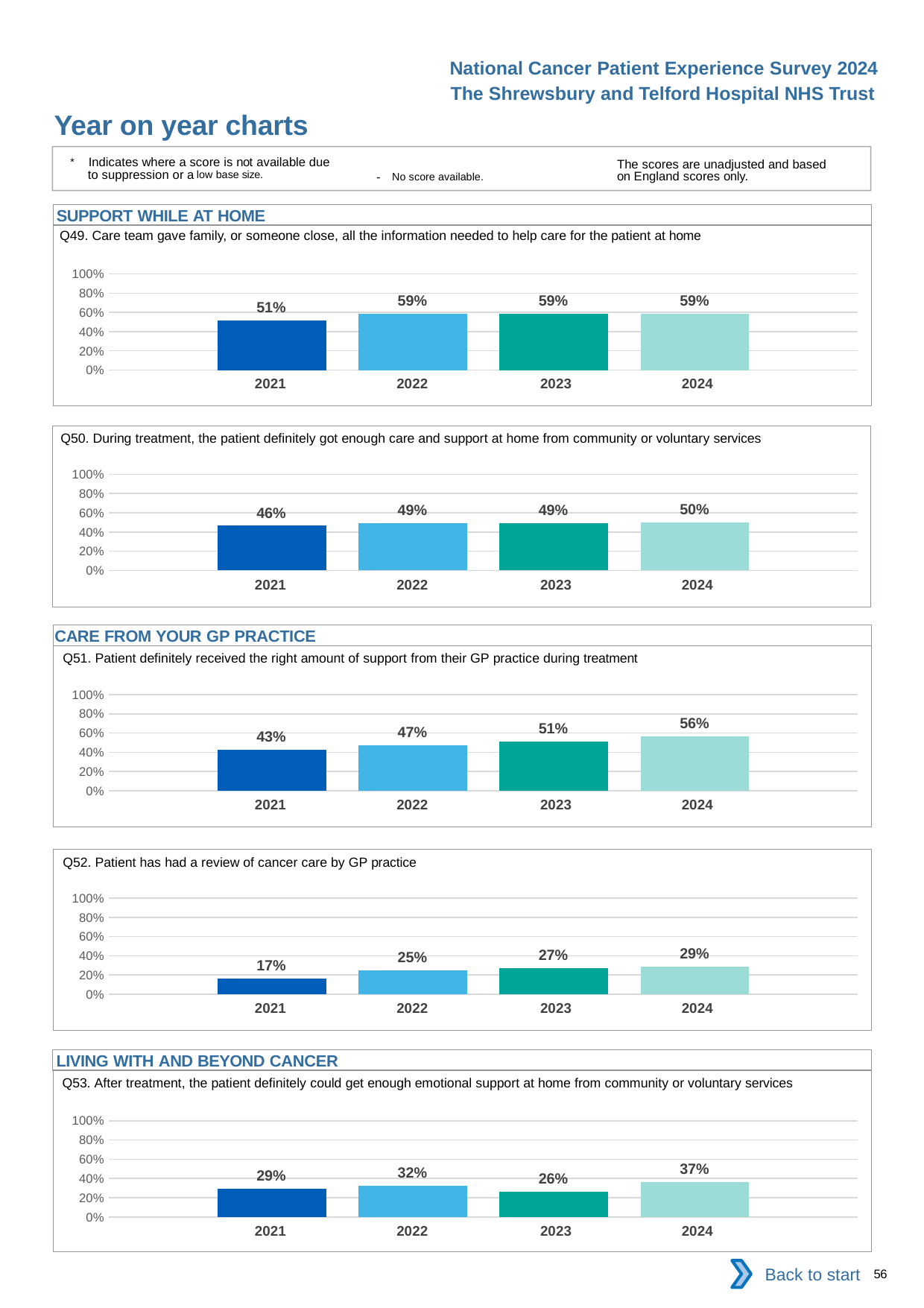
In the Q52 chart, is the value for 2024 greater or less than 40%? less In the Q52 chart, what is the difference between the 2022 and 2021 values? 8% In the Q52 chart, which year has the lowest value? 2021 In the Q51 chart, which year has the highest value? 2024 In the Q49 chart, what is the value for 2021? 51% In the Q51 chart, do the values rise or fall from 2021 to 2024? rise In the Q51 chart, is the value for 2022 or 2023 larger? 2023 In the Q50 chart, what is the value for 2024? 50% Which section heading appears above the Q53 chart? LIVING WITH AND BEYOND CANCER In the Q53 chart, what is the difference between the 2024 and 2023 values? 11% What kind of chart is the Q49 chart? bar chart How many years are shown on the x axis of the Q50 chart? 4